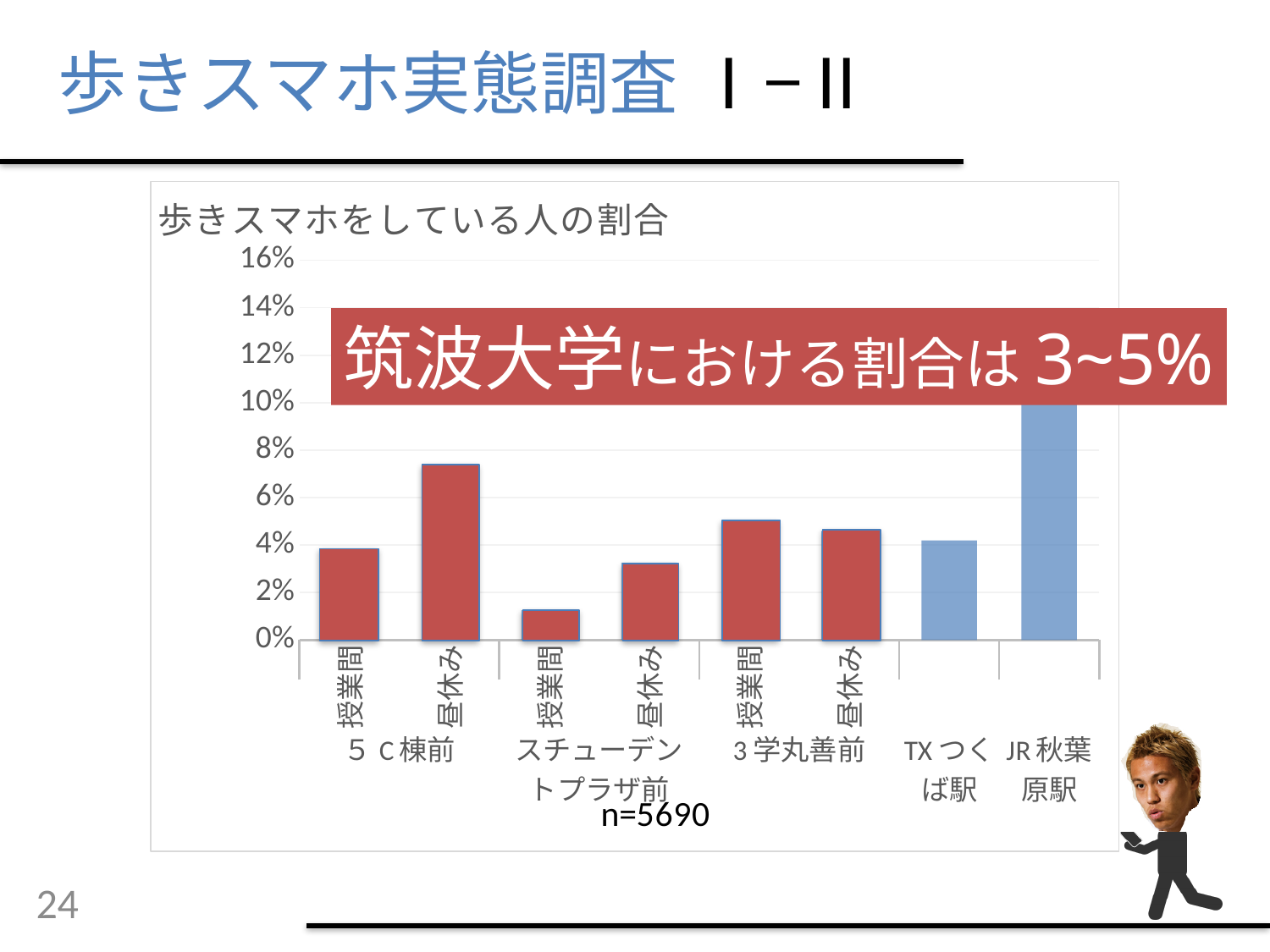
What is the title of the chart? 歩きスマホをしている人の割合 What is the sample size (n) noted below the chart? n=5690 Is the value for TXつくば駅 greater or less than 6%? less Is the value for JR秋葉原駅 greater or less than 10%? greater How many bars are plotted in the chart? 8 Which is larger: the value for JR秋葉原駅 or the value for TXつくば駅? JR秋葉原駅 What kind of chart is shown on the slide? bar chart At 5C棟前, which is larger: 授業間 or 昼休み? 昼休み Which bar has the lowest value in the chart? スチューデントプラザ前 授業間 Which bar has the highest value in the chart? JR秋葉原駅 Is the value for スチューデントプラザ前 授業間 greater or less than 2%? less